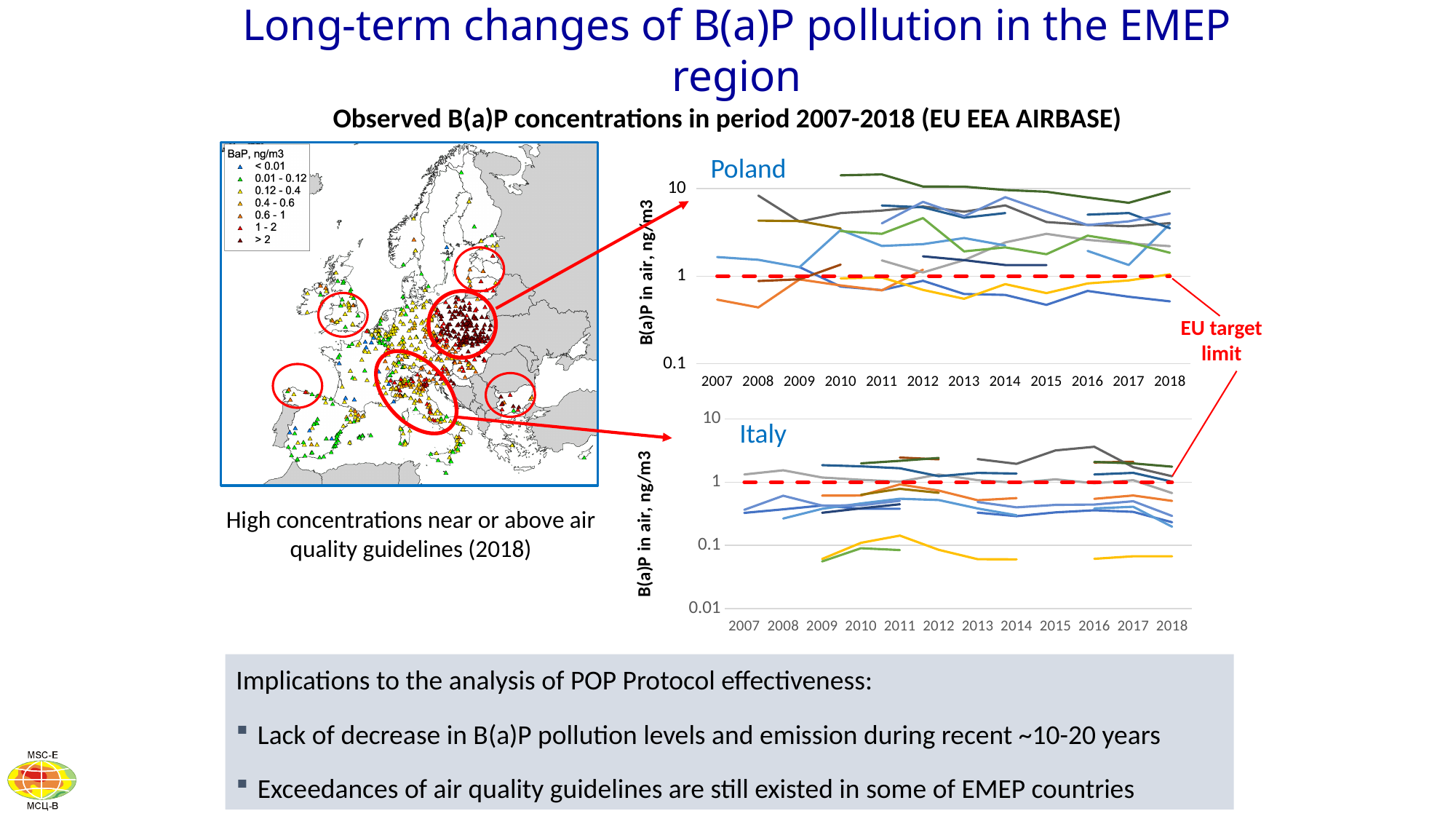
In the Italy chart, is the value of the lowest line in 2013 greater or less than 0.1? less What kind of chart is the Poland chart? line chart In the Poland chart, at which y-axis value is the red dashed EU target limit line drawn? 1 In the Italy chart, what is the last year on the x axis? 2018 In the Italy chart, what is the lowest tick value shown on the y axis? 0.01 What does the red dashed line in the Poland and Italy charts represent? EU target limit What kind of chart is the Italy chart? line chart How many years are shown on the x axis of the Italy chart? 12 How many years are shown on the x axis of the Poland chart? 12 What is the y-axis label of the Poland chart? B(a)P in air, ng/m3 In the Poland chart, what is the first year on the x axis? 2007 In the Poland chart, is the value of the highest line in 2010 greater or less than 10? greater